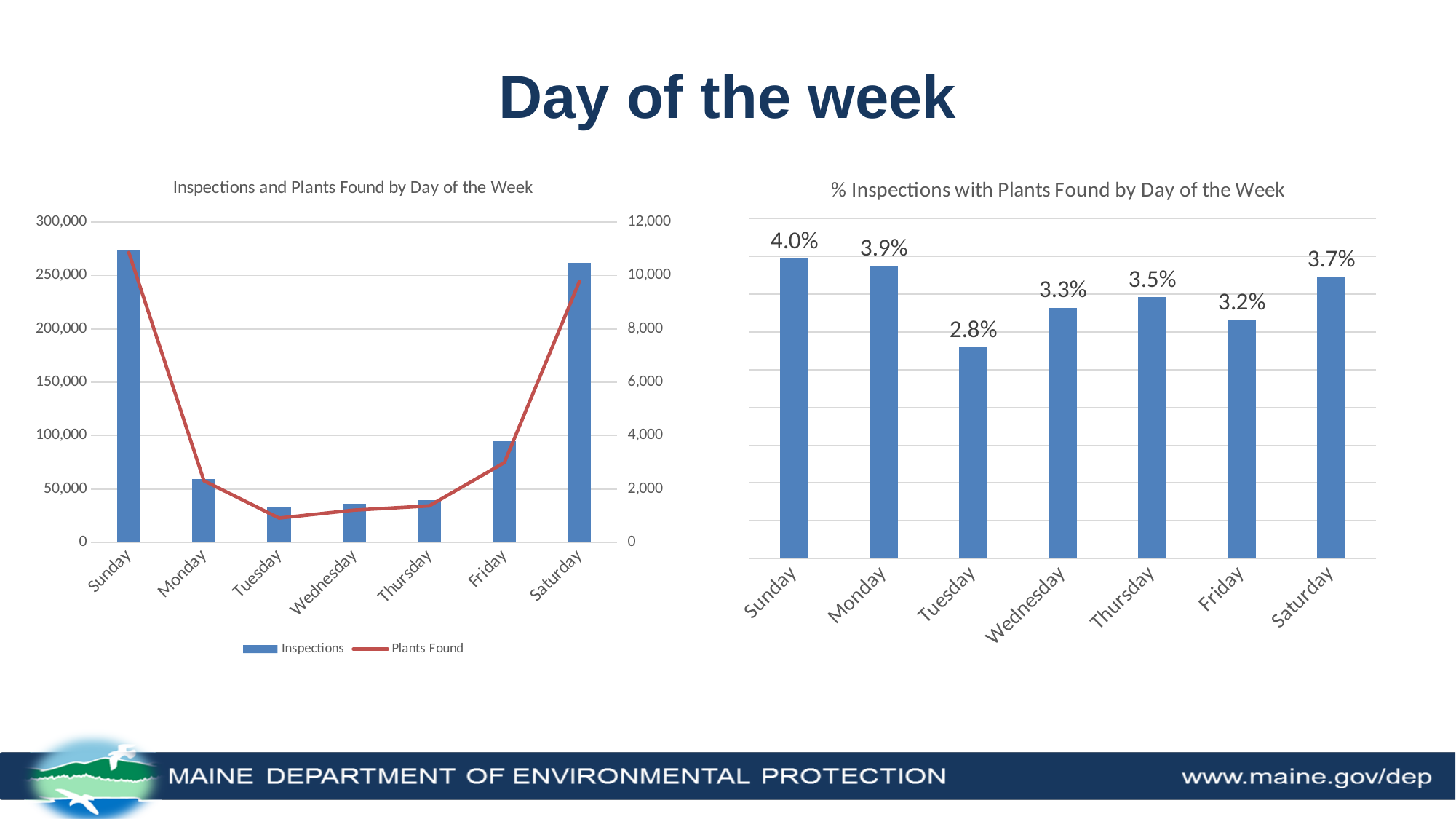
In the '% Inspections with Plants Found by Day of the Week' chart, which day has the highest value? Sunday In the '% Inspections with Plants Found by Day of the Week' chart, which day has the lowest value? Tuesday In the 'Inspections and Plants Found by Day of the Week' chart, is the number of Inspections on Tuesday greater or less than 50,000? less How many series does the legend of the 'Inspections and Plants Found by Day of the Week' chart list? 2 How many days are shown on the x axis of the '% Inspections with Plants Found by Day of the Week' chart? 7 In the 'Inspections and Plants Found by Day of the Week' chart, is the number of Inspections on Sunday greater or less than 250,000? greater In the 'Inspections and Plants Found by Day of the Week' chart, do the Inspections values rise or fall from Sunday to Tuesday? fall In the '% Inspections with Plants Found by Day of the Week' chart, what is the value for Sunday? 4.0% In the 'Inspections and Plants Found by Day of the Week' chart, which day has the highest number of Inspections? Sunday In the '% Inspections with Plants Found by Day of the Week' chart, what is the value for Thursday? 3.5% In the '% Inspections with Plants Found by Day of the Week' chart, what is the difference between the Sunday and Tuesday values? 1.2% In the '% Inspections with Plants Found by Day of the Week' chart, which is larger, the value for Wednesday or the value for Friday? Wednesday